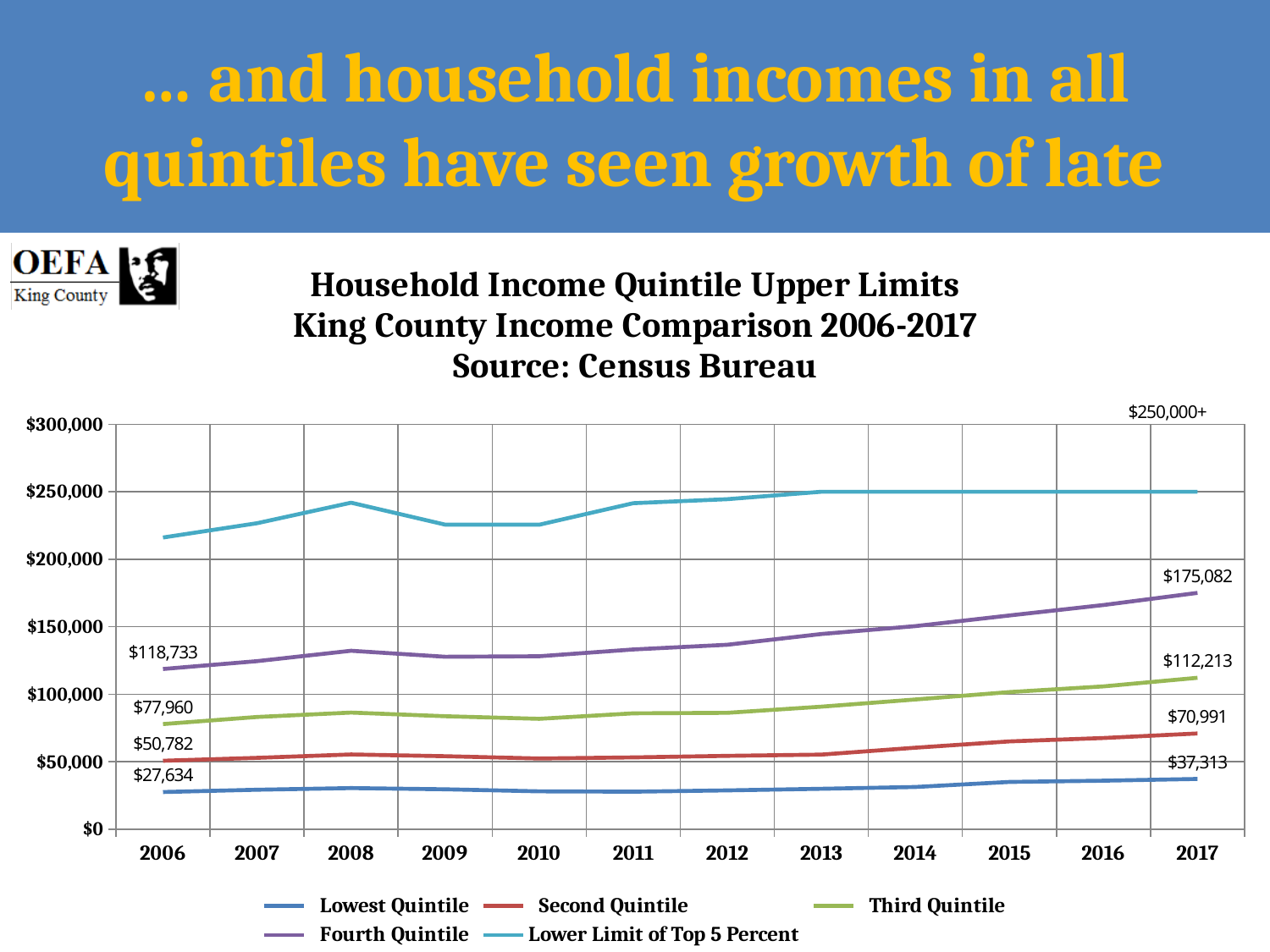
What is the value for the Fourth Quintile in 2006? $118,733 How many years are plotted along the x axis? 12 By how much did the Second Quintile upper limit increase from 2006 to 2017? $20,209 What type of chart is shown on the slide? Line chart How many series does the legend list? 5 Which series has the highest values across the chart? Lower Limit of Top 5 Percent What is the value for the Second Quintile in 2006? $50,782 Does the Third Quintile line rise or fall from 2013 to 2017? Rise What is the labelled value for the Lower Limit of Top 5 Percent in 2017? $250,000+ Is the value for the Fourth Quintile in 2012 greater or less than $150,000? less What is the value for the Lowest Quintile in 2017? $37,313 What is the value for the Third Quintile in 2017? $112,213